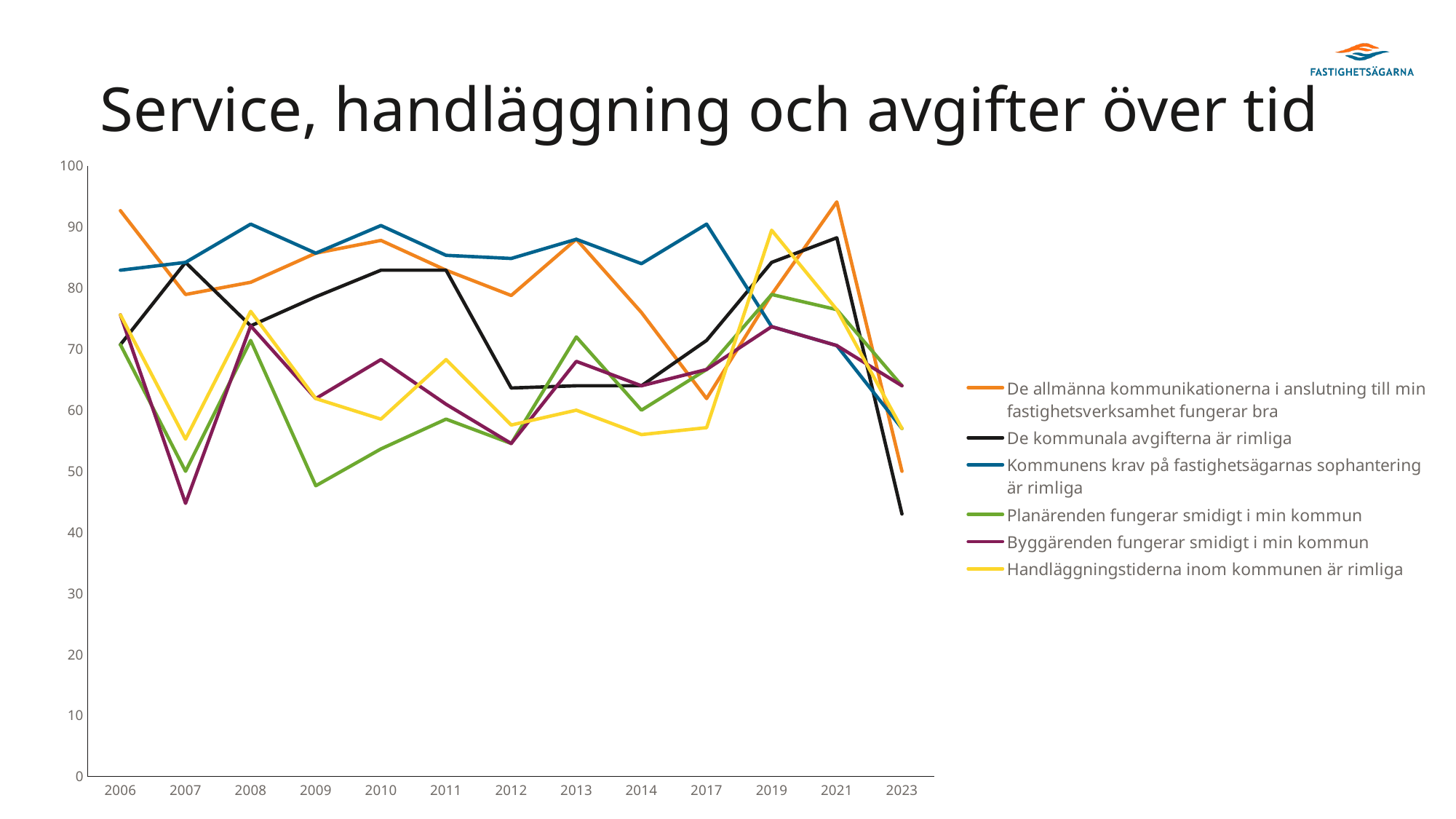
In which year is 'De kommunala avgifterna är rimliga' at its lowest? 2023 Is the value for 'De kommunala avgifterna är rimliga' in 2023 greater or less than 50? less What kind of chart is shown on the slide? line chart How many series does the legend list? 6 Does the value for 'De kommunala avgifterna är rimliga' rise or fall from 2021 to 2023? fall Which series has the highest value in 2019? Handläggningstiderna inom kommunen är rimliga Is the value for 'De allmänna kommunikationerna i anslutning till min fastighetsverksamhet fungerar bra' in 2006 greater or less than 90? greater In 2023, which is larger: 'De allmänna kommunikationerna i anslutning till min fastighetsverksamhet fungerar bra' or 'De kommunala avgifterna är rimliga'? De allmänna kommunikationerna i anslutning till min fastighetsverksamhet fungerar bra Is the value for 'Byggärenden fungerar smidigt i min kommun' in 2007 greater or less than 50? less How many years are shown on the x axis? 13 Which series has the lowest value in 2007? Byggärenden fungerar smidigt i min kommun